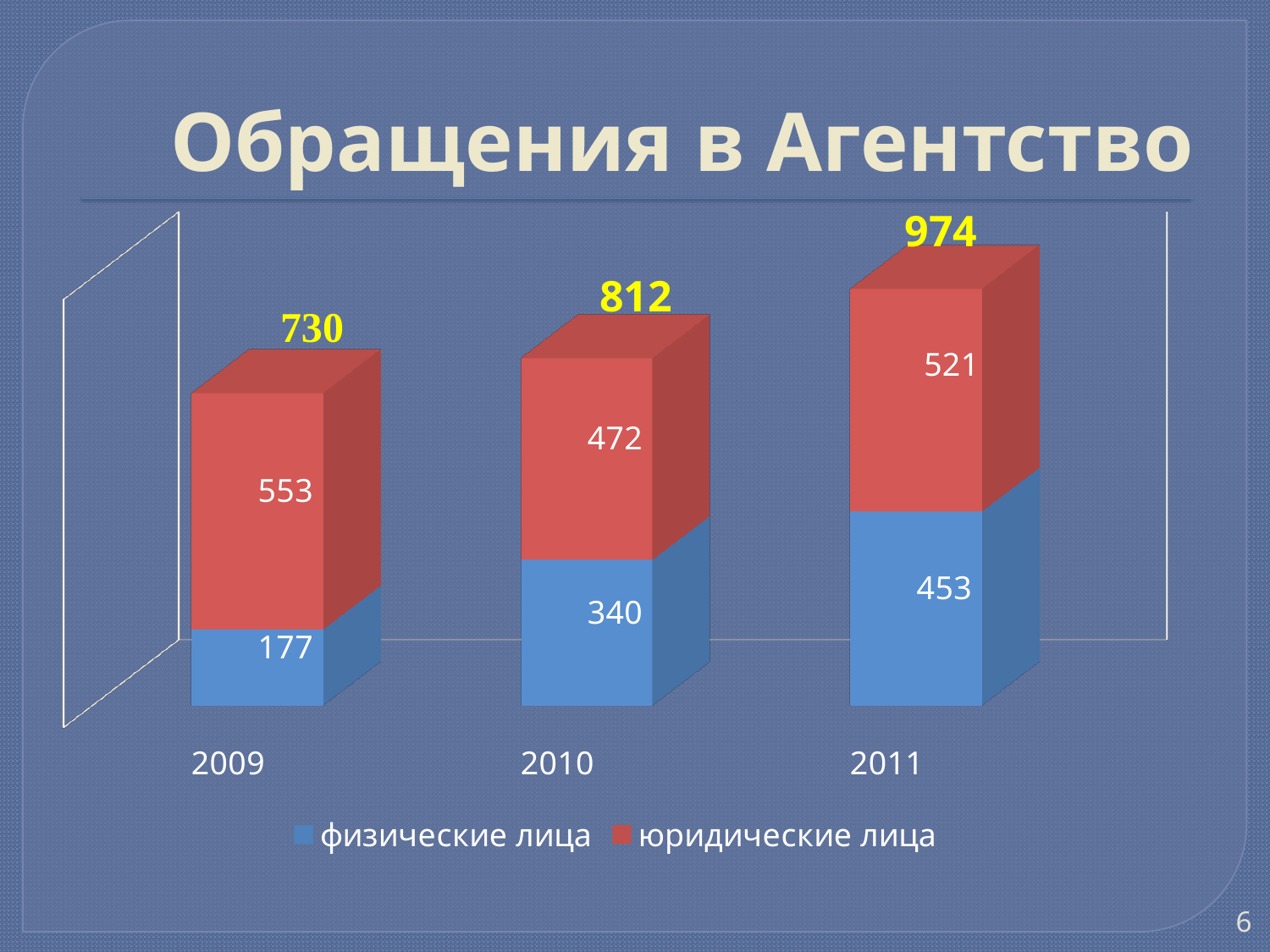
Do the bar totals rise or fall from 2009 to 2011? rise Which year has the highest value for физические лица? 2011 How many years are shown on the x axis? 3 How many series does the legend list? 2 What is the difference between the физические лица values for 2011 and 2009? 276 What is the value for физические лица in 2009? 177 Which year has the lowest value for юридические лица? 2010 What is the total of the stacked bar for 2010? 812 What is the value for юридические лица in 2011? 521 What is the value for юридические лица in 2010? 472 Which is larger in 2010: физические лица or юридические лица? юридические лица What is the total of the stacked bar for 2011? 974